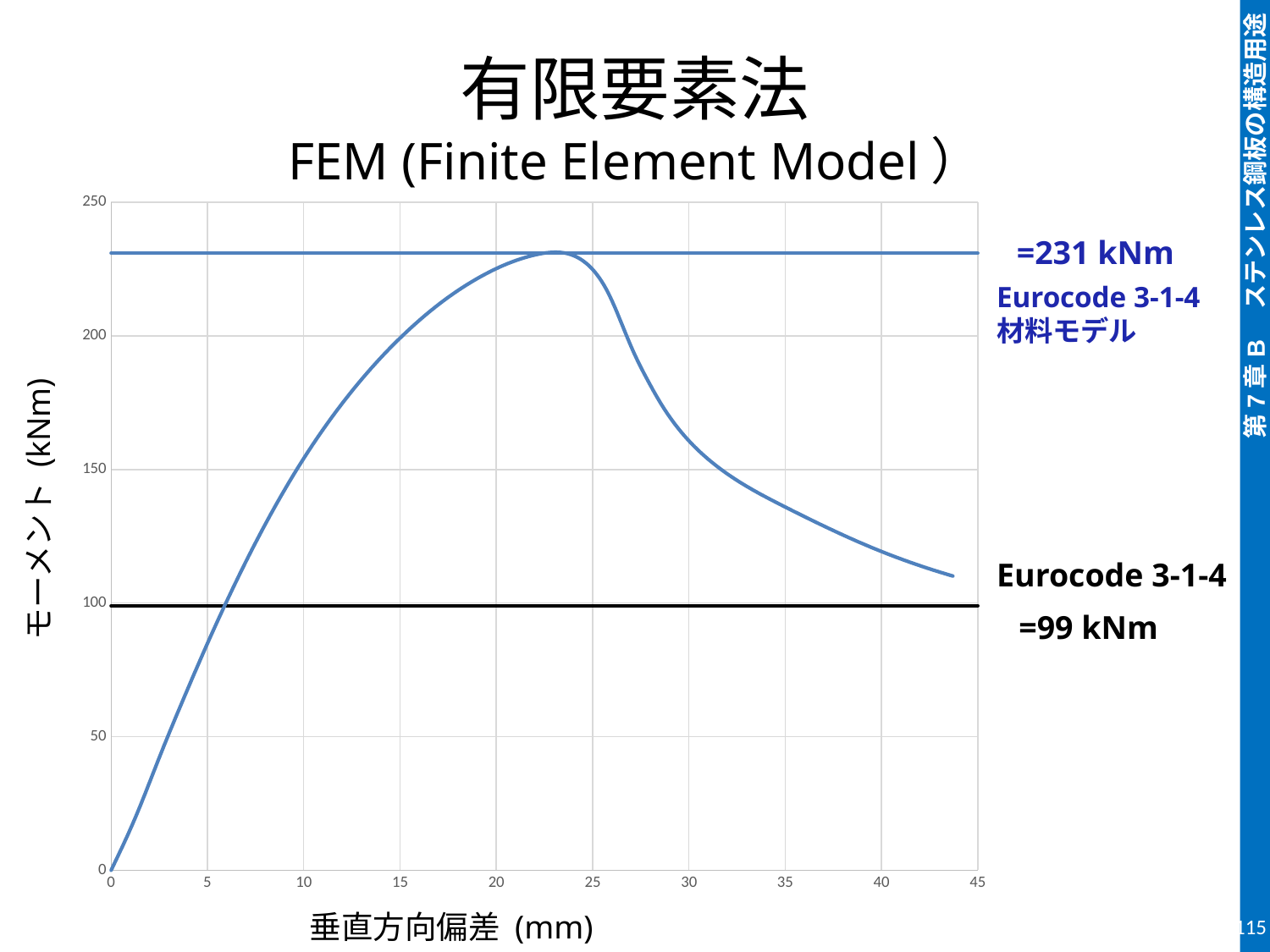
Is the moment on the curve at a vertical deflection of 20 mm greater or less than 200? greater What is the difference between the 231 kNm line and the 99 kNm line? 132 kNm What moment value does the blue horizontal line (Eurocode 3-1-4 材料モデル) represent? 231 kNm Is the moment on the curve at a vertical deflection of 5 mm greater or less than 100? less What is the label of the horizontal axis? 垂直方向偏差 (mm) Which horizontal reference line is higher, the blue one or the black one? the blue one (231 kNm) What is the label of the vertical axis? モーメント (kNm) What is the maximum value shown on the vertical axis? 250 Does the curve rise or fall between a vertical deflection of 25 mm and 45 mm? fall What moment value does the black horizontal line (Eurocode 3-1-4) represent? 99 kNm What kind of chart is shown on the slide? line chart Is the moment on the curve at a vertical deflection of 40 mm greater or less than 150? less